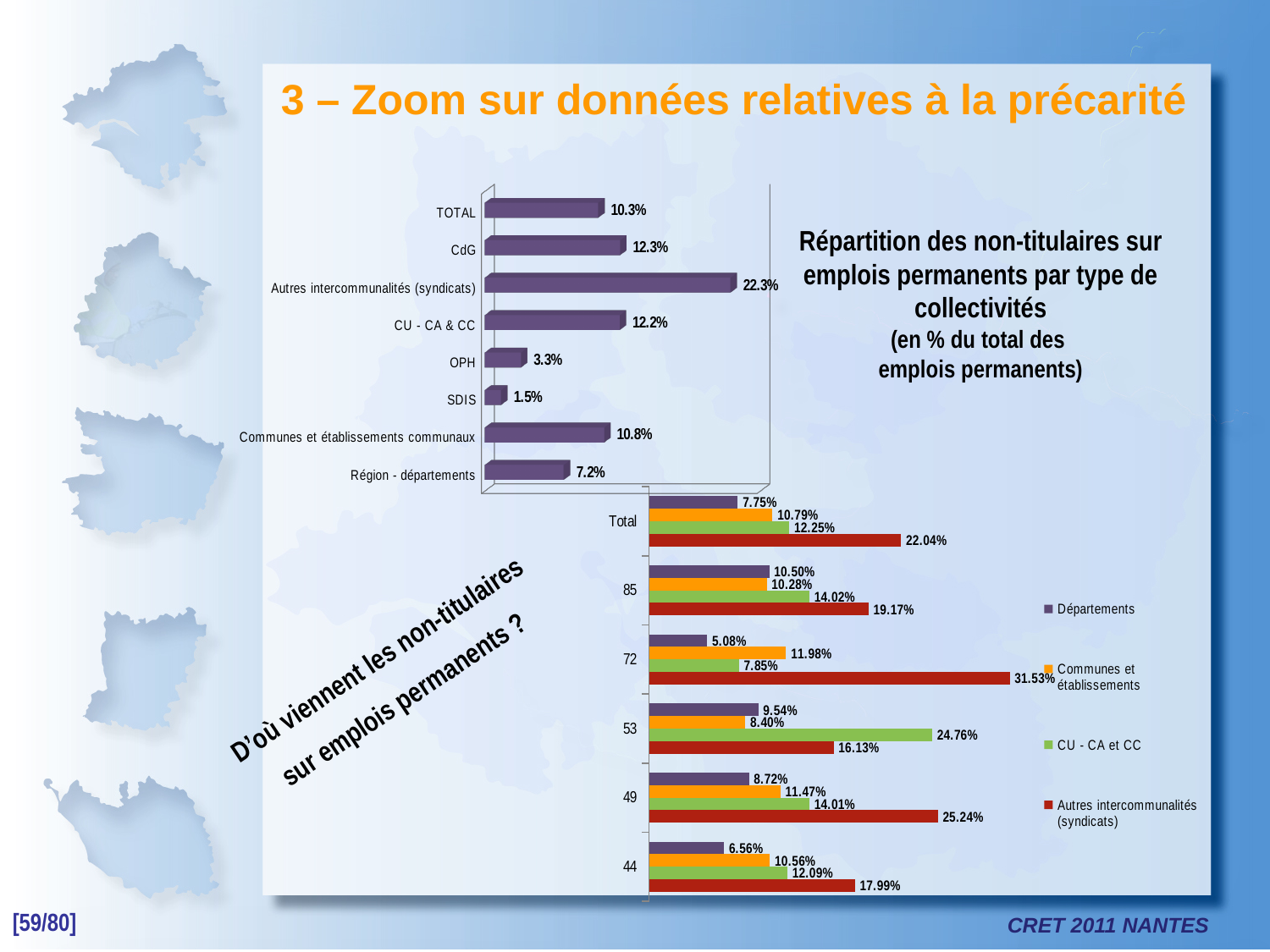
In the upper chart (Répartition des non-titulaires sur emplois permanents par type de collectivités), what is the difference between the values for CdG and OPH? 9.0% In the lower chart, what is the value for Départements in the Total category? 7.75% In the upper chart (Répartition des non-titulaires sur emplois permanents par type de collectivités), what is the value for Autres intercommunalités (syndicats)? 22.3% In the upper chart (Répartition des non-titulaires sur emplois permanents par type de collectivités), which category has the highest value? Autres intercommunalités (syndicats) What kind of chart is the upper chart (Répartition des non-titulaires sur emplois permanents par type de collectivités)? Bar chart In the upper chart (Répartition des non-titulaires sur emplois permanents par type de collectivités), how many categories are shown? 8 In the lower chart, which series is shown in red? Autres intercommunalités (syndicats) In the upper chart (Répartition des non-titulaires sur emplois permanents par type de collectivités), which category has the lowest value? SDIS In the lower chart, what is the difference between the Autres intercommunalités (syndicats) value and the Départements value in category 49? 16.52% In the lower chart, how many series does the legend list? 4 In the lower chart, which is larger in category 53: CU - CA et CC or Autres intercommunalités (syndicats)? CU - CA et CC In the lower chart, what is the value for Autres intercommunalités (syndicats) in category 72? 31.53%